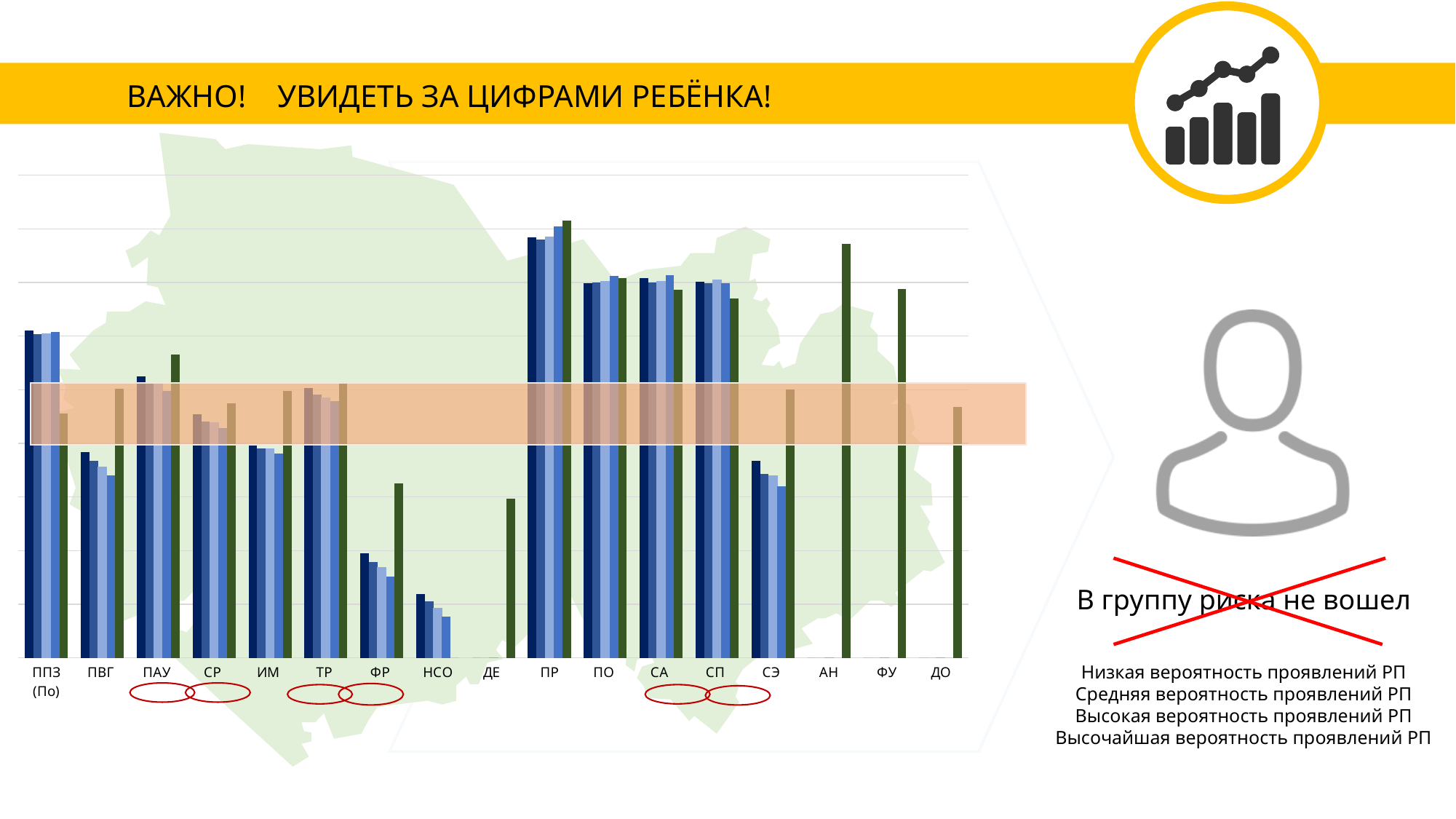
Which category has taller blue bars, ПО or СЭ? ПО Which category has a taller green bar, АН or ДО? АН What is the label of the first category on the x axis of the chart? ППЗ (По) Which category has taller blue bars, ФР or НСО? ФР What colour is the horizontal band drawn across the middle of the chart? orange Among the categories with blue bars, which has the shortest blue bars? НСО How many categories are labelled along the x axis of the chart? 17 Which category has the tallest bars in the chart? ПР What kind of chart is shown on the slide? bar chart